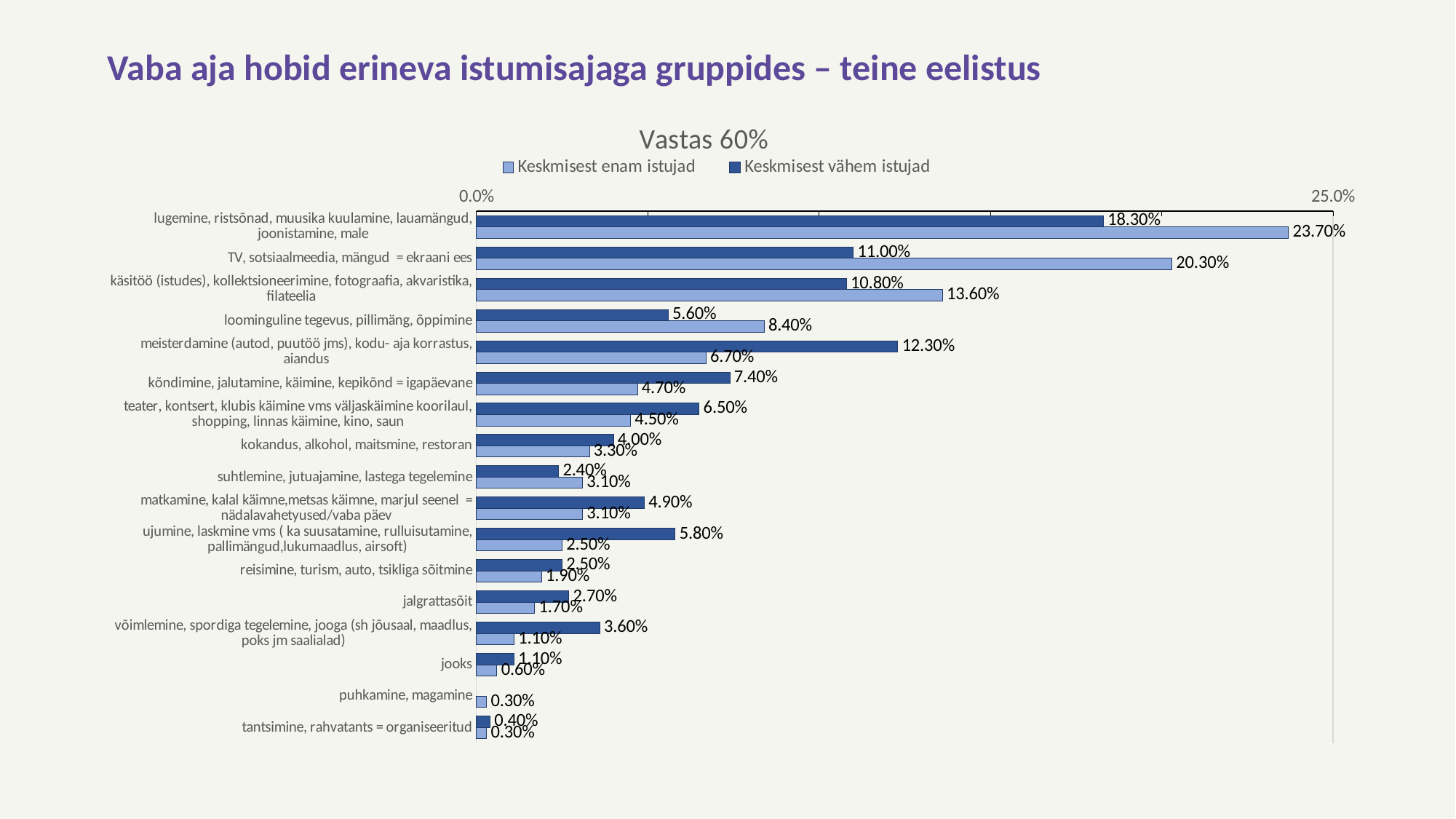
What is the value for 'Keskmisest vähem istujad' in the category 'võimlemine, spordiga tegelemine, jooga (sh jõusaal, maadlus, poks jm saalialad)'? 3.60% How many categories are shown on the chart? 17 Which category has the highest value for 'Keskmisest enam istujad'? lugemine, ristsõnad, muusika kuulamine, lauamängud, joonistamine, male Which category has the lowest value for 'Keskmisest vähem istujad' among those with a plotted bar? tantsimine, rahvatants = organiseeritud What is the value for 'Keskmisest enam istujad' in the category 'TV, sotsiaalmeedia, mängud = ekraani ees'? 20.30% For 'ujumine, laskmine vms ( ka suusatamine, rulluisutamine, pallimängud,lukumaadlus, airsoft)', which series has the larger value? Keskmisest vähem istujad What is the difference between the 'Keskmisest enam istujad' and 'Keskmisest vähem istujad' values for 'TV, sotsiaalmeedia, mängud = ekraani ees'? 9.30% How many series does the legend list? 2 What kind of chart is shown on the slide? bar chart What is the difference between the 'Keskmisest enam istujad' and 'Keskmisest vähem istujad' values for 'lugemine, ristsõnad, muusika kuulamine, lauamängud, joonistamine, male'? 5.40% What is the title of the chart? Vastas 60% What is the value for 'Keskmisest vähem istujad' in the category 'meisterdamine (autod, puutöö jms), kodu- aja korrastus, aiandus'? 12.30%